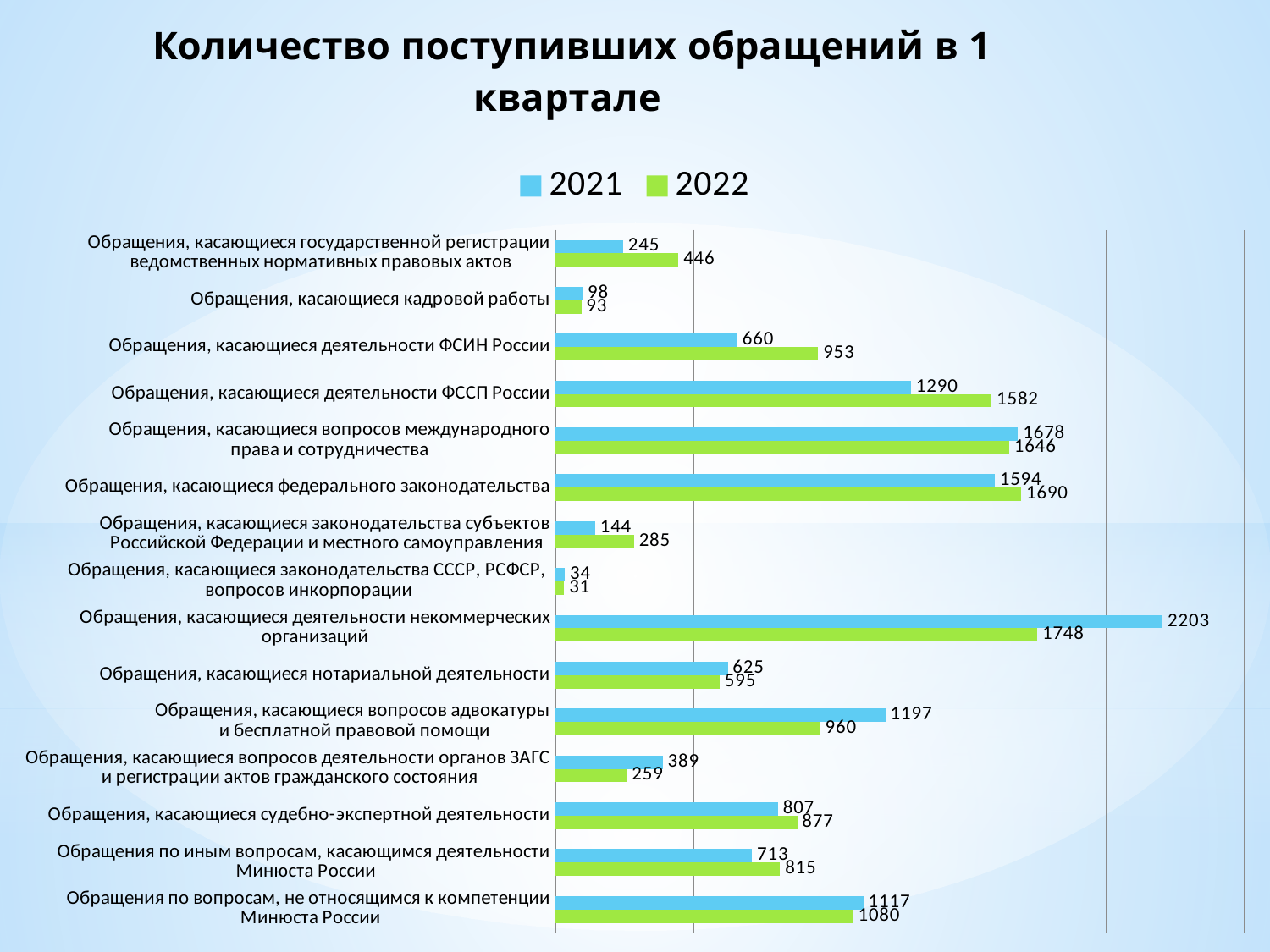
How many categories are plotted in the chart? 15 What type of chart is shown on the slide? Bar chart What is the difference between the 2021 and 2022 values for 'Обращения, касающиеся деятельности некоммерческих организаций'? 455 For 'Обращения, касающиеся федерального законодательства', which year has the larger value, 2021 or 2022? 2022 How many series does the legend list? 2 Which category has the highest 2021 value? Обращения, касающиеся деятельности некоммерческих организаций What is the difference between the 2022 and 2021 values for 'Обращения, касающиеся деятельности ФССП России'? 292 What is the 2022 value for 'Обращения, касающиеся государственной регистрации ведомственных нормативных правовых актов'? 446 What is the title of the chart? Количество поступивших обращений в 1 квартале Which category has the lowest 2022 value? Обращения, касающиеся законодательства СССР, РСФСР, вопросов инкорпорации What is the 2021 value for 'Обращения, касающиеся вопросов адвокатуры и бесплатной правовой помощи'? 1197 What is the 2022 value for 'Обращения, касающиеся деятельности ФСИН России'? 953